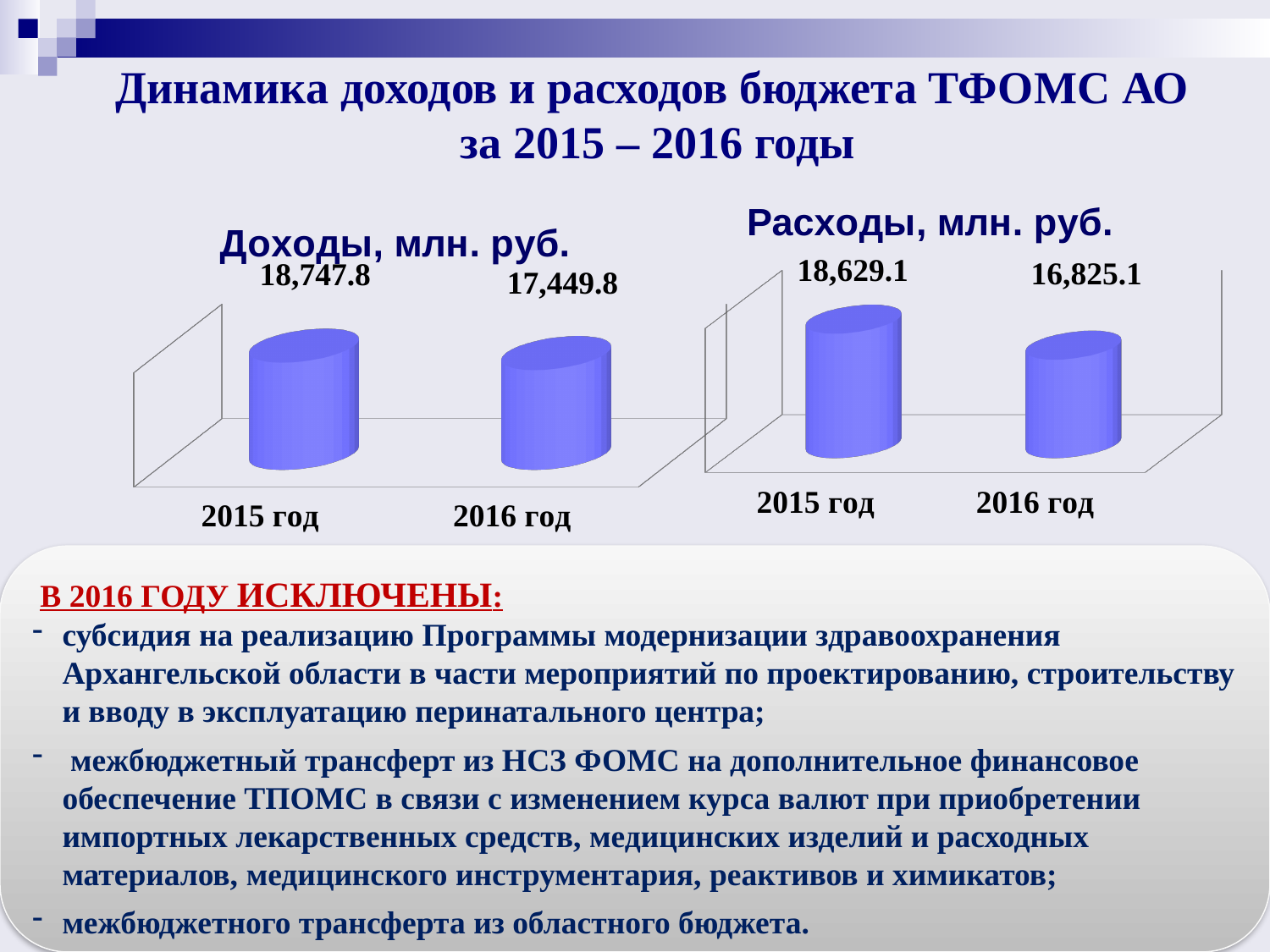
For 2015 год, which is larger: the value in the «Доходы, млн. руб.» chart or the value in the «Расходы, млн. руб.» chart? Доходы, млн. руб. In the chart titled «Доходы, млн. руб.», what is the value for 2015 год? 18,747.8 In the chart titled «Расходы, млн. руб.», what is the value for 2016 год? 16,825.1 In the chart titled «Доходы, млн. руб.», which year has the higher value? 2015 год In the chart titled «Расходы, млн. руб.», what is the value for 2015 год? 18,629.1 What type of chart is the chart titled «Расходы, млн. руб.»? bar chart In the chart titled «Доходы, млн. руб.», by how much does the 2015 год value exceed the 2016 год value? 1,298.0 In the chart titled «Расходы, млн. руб.», which year has the lower value? 2016 год In the chart titled «Расходы, млн. руб.», do the values rise or fall from 2015 год to 2016 год? fall How many categories are shown in the chart titled «Доходы, млн. руб.»? 2 In the chart titled «Расходы, млн. руб.», what is the difference between the 2015 год and 2016 год values? 1,804.0 In the chart titled «Доходы, млн. руб.», what is the value for 2016 год? 17,449.8